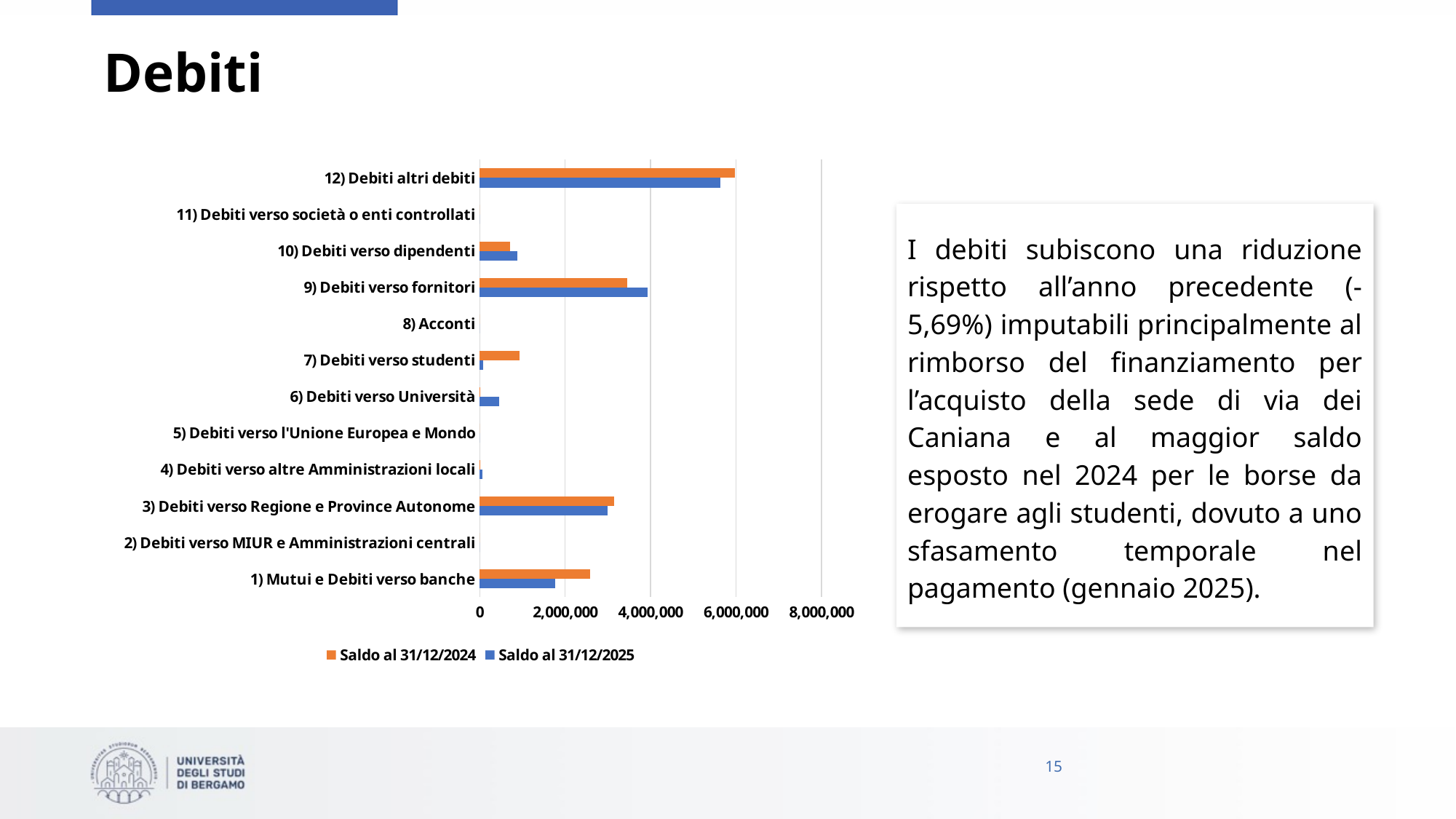
How many series does the legend list? 2 What colour represents the Saldo al 31/12/2024 series in the chart? Orange How many categories are shown on the vertical axis of the chart? 12 For 7) Debiti verso studenti, which series has the larger value: Saldo al 31/12/2024 or Saldo al 31/12/2025? Saldo al 31/12/2024 What kind of chart is shown on the slide? Bar chart Is the Saldo al 31/12/2024 value for 12) Debiti altri debiti greater or less than 4,000,000? greater For 1) Mutui e Debiti verso banche, which series has the larger value: Saldo al 31/12/2024 or Saldo al 31/12/2025? Saldo al 31/12/2024 Which category has the highest value for Saldo al 31/12/2025? 12) Debiti altri debiti For 9) Debiti verso fornitori, which series has the larger value: Saldo al 31/12/2024 or Saldo al 31/12/2025? Saldo al 31/12/2025 Is the Saldo al 31/12/2025 value for 1) Mutui e Debiti verso banche greater or less than 2,000,000? less Is the Saldo al 31/12/2025 value for 9) Debiti verso fornitori greater or less than 2,000,000? greater Which category has the highest value for Saldo al 31/12/2024? 12) Debiti altri debiti